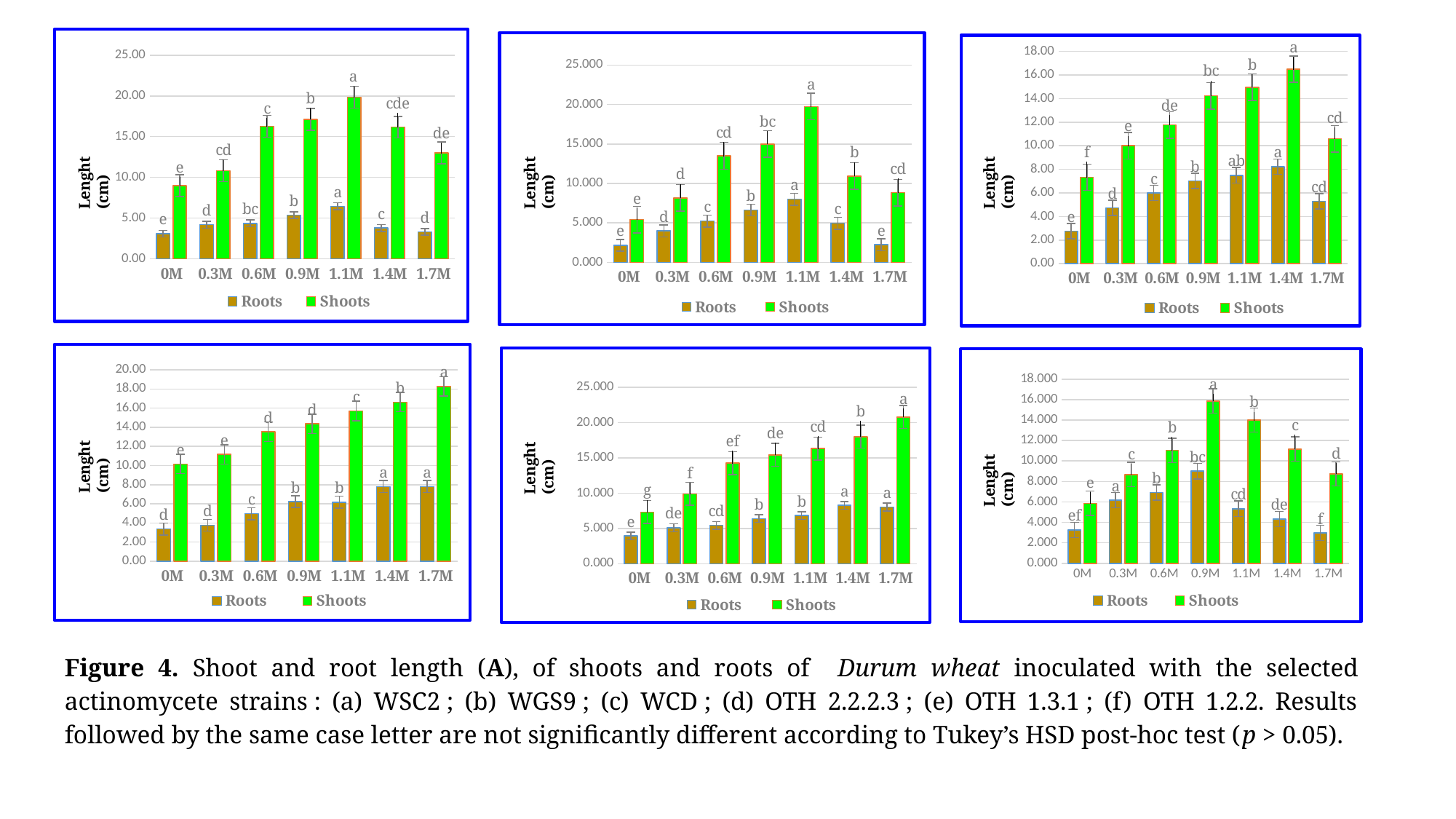
In the bottom-left chart, is the Shoots value for 1.7M greater or less than 16.00? greater In the top-left chart, which is larger: the Roots value for 1.1M or the Roots value for 0M? 1.1M In the bottom-middle chart, which category has the highest Shoots value? 1.7M In the top-middle chart, which category has the lowest Shoots value? 0M In the bottom-right chart, which category has the tallest Shoots bar? 0.9M How many categories are shown on the x axis of the top-left chart? 7 How many series does the legend of the bottom-right chart list? 2 What kind of chart is the top-middle chart? bar chart In the bottom-left chart, do the Shoots values rise or fall from 0M to 1.7M? rise In the top-left chart, which category has the tallest Shoots bar? 1.1M In the top-left chart, is the Shoots value for 1.1M greater or less than 15.00? greater